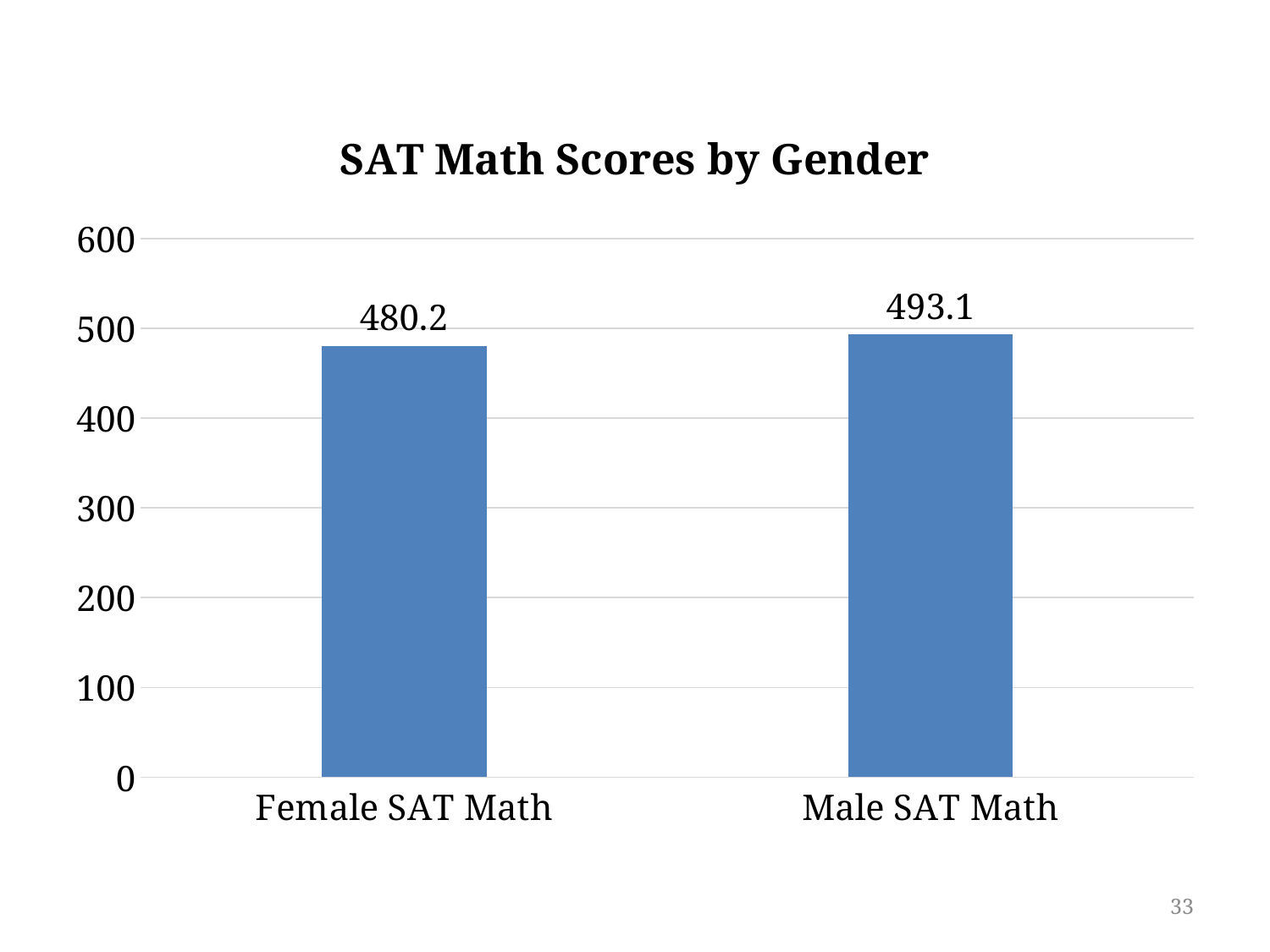
Which is larger, the value for Female SAT Math or Male SAT Math? Male SAT Math What is the highest value shown on the vertical axis? 600 What kind of chart is shown on the slide? bar chart How many categories are shown in the chart? 2 What is the value for Female SAT Math? 480.2 What is the difference between the Male SAT Math and Female SAT Math values? 12.9 What is the title of the chart? SAT Math Scores by Gender What is the value for Male SAT Math? 493.1 Is the value for Female SAT Math greater or less than 500? less Is the value for Male SAT Math greater or less than 400? greater Which category has the highest value? Male SAT Math Which category has the lowest value? Female SAT Math